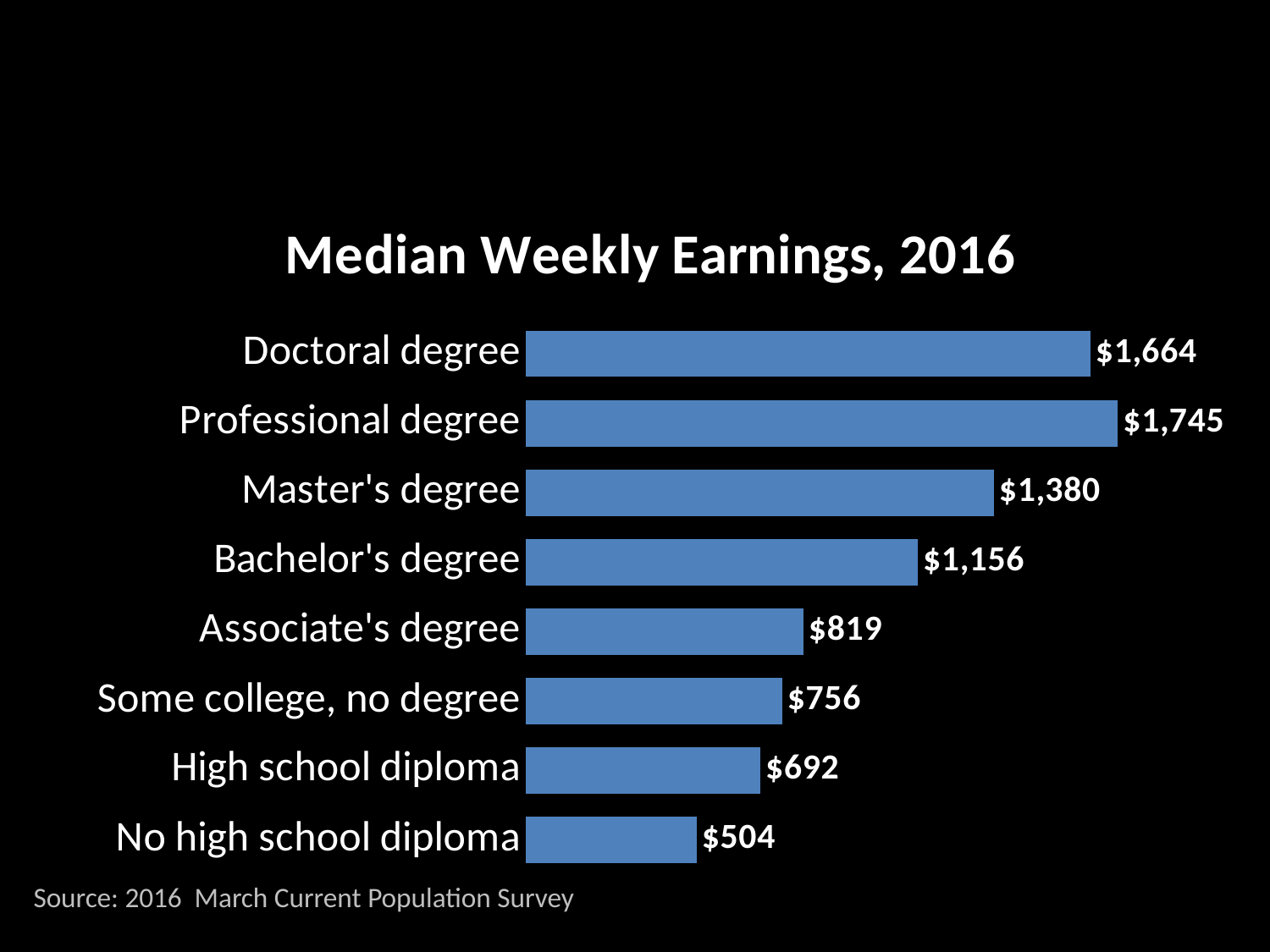
What is the difference in median weekly earnings between a Professional degree and a Doctoral degree? $81 What kind of chart is shown on the slide? Bar chart Which category has the lowest median weekly earnings? No high school diploma What is the median weekly earnings for No high school diploma? $504 What is the median weekly earnings for a Bachelor's degree? $1,156 What is the title of the chart? Median Weekly Earnings, 2016 Which has higher median weekly earnings, an Associate's degree or Some college, no degree? Associate's degree How many education categories are shown in the chart? 8 What is the difference in median weekly earnings between a High school diploma and No high school diploma? $188 What is the median weekly earnings for a Doctoral degree? $1,664 Which has higher median weekly earnings, a Master's degree or a Bachelor's degree? Master's degree Which category has the highest median weekly earnings? Professional degree